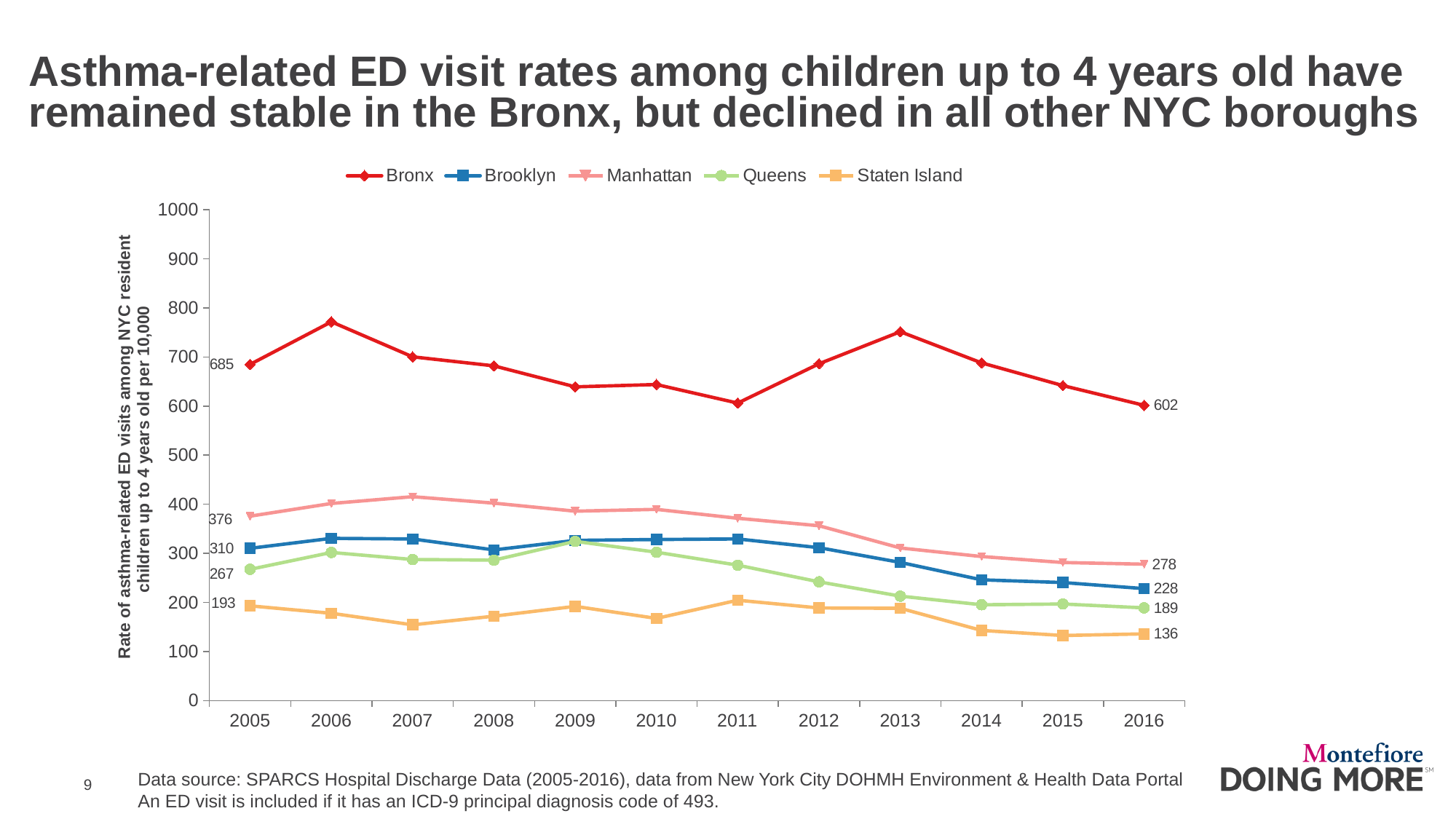
Which borough had the lowest asthma-related ED visit rate in 2005? Staten Island What was the Staten Island rate in 2016? 136 What was the Bronx asthma-related ED visit rate in 2005? 685 How many years are shown on the x axis? 12 By how much did the Brooklyn rate fall from 2005 to 2016? 82 Which borough had the highest asthma-related ED visit rate in 2016? Bronx In 2016, which was higher: the Queens rate or the Brooklyn rate? Brooklyn Is the Bronx value for 2006 greater or less than 700? greater How many boroughs does the legend list? 5 What was the Manhattan rate in 2005? 376 What kind of chart is shown on the slide? Line chart What was the Bronx asthma-related ED visit rate in 2016? 602